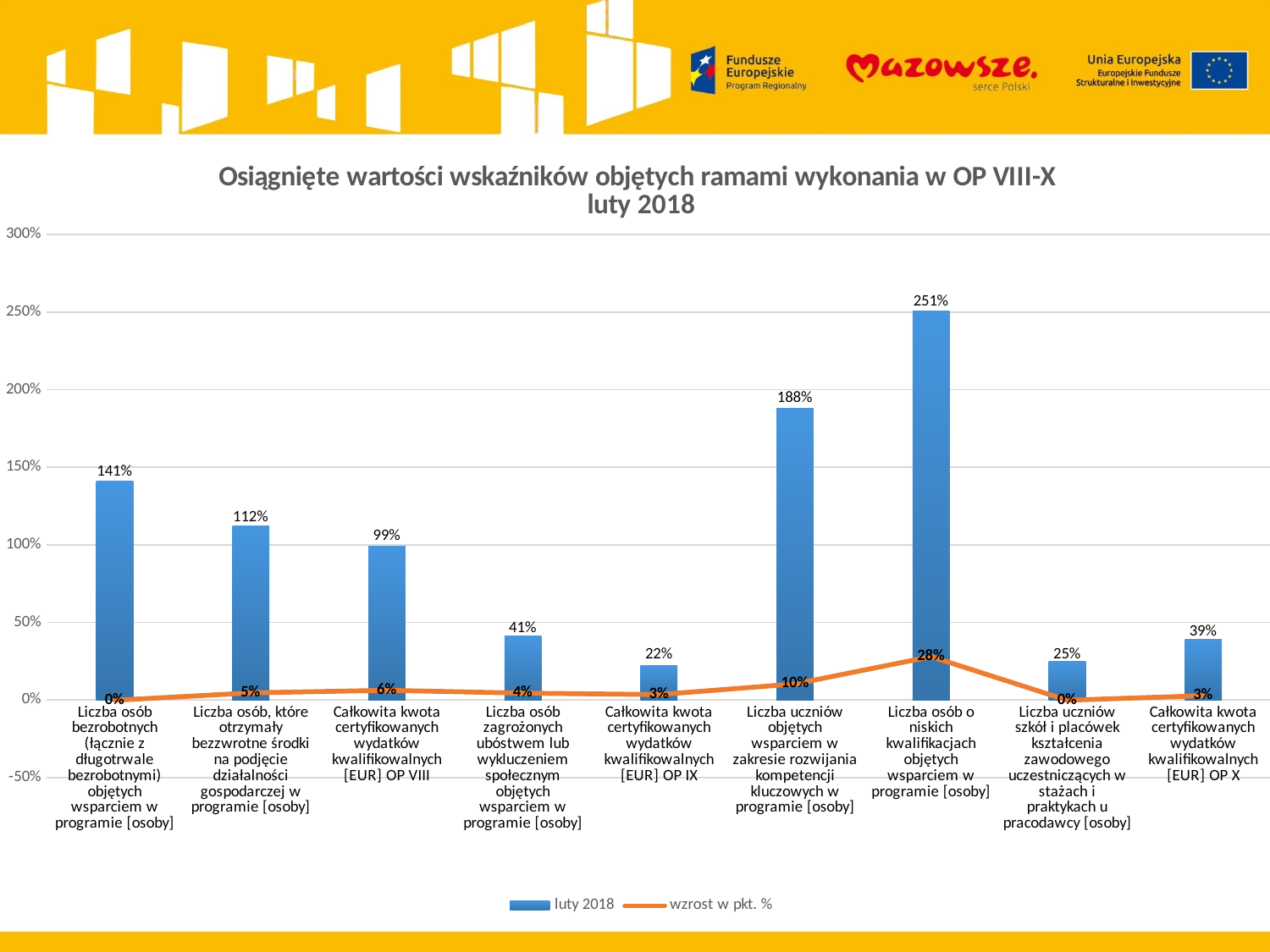
What is the 'luty 2018' value for 'Liczba uczniów objętych wsparciem w zakresie rozwijania kompetencji kluczowych w programie [osoby]'? 188% What is the difference between the 'luty 2018' values for 'Liczba osób o niskich kwalifikacjach objętych wsparciem w programie [osoby]' and 'Liczba uczniów objętych wsparciem w zakresie rozwijania kompetencji kluczowych w programie [osoby]'? 63% How many categories are shown on the x axis? 9 What kind of chart is shown on the slide? Bar chart with a line Which category has the highest 'luty 2018' value? Liczba osób o niskich kwalifikacjach objętych wsparciem w programie [osoby] Which has a larger 'luty 2018' value: 'Liczba osób bezrobotnych (łącznie z długotrwale bezrobotnymi) objętych wsparciem w programie [osoby]' or 'Liczba osób, które otrzymały bezzwrotne środki na podjęcie działalności gospodarczej w programie [osoby]'? Liczba osób bezrobotnych (łącznie z długotrwale bezrobotnymi) objętych wsparciem w programie [osoby] What is the title of the chart? Osiągnięte wartości wskaźników objętych ramami wykonania w OP VIII-X luty 2018 How many series does the legend list? 2 What is the 'luty 2018' value for 'Całkowita kwota certyfikowanych wydatków kwalifikowalnych [EUR] OP VIII'? 99% What is the 'luty 2018' value for 'Całkowita kwota certyfikowanych wydatków kwalifikowalnych [EUR] OP X'? 39% What is the 'wzrost w pkt. %' value for 'Liczba osób o niskich kwalifikacjach objętych wsparciem w programie [osoby]'? 28% Which category has the lowest 'luty 2018' value? Całkowita kwota certyfikowanych wydatków kwalifikowalnych [EUR] OP IX